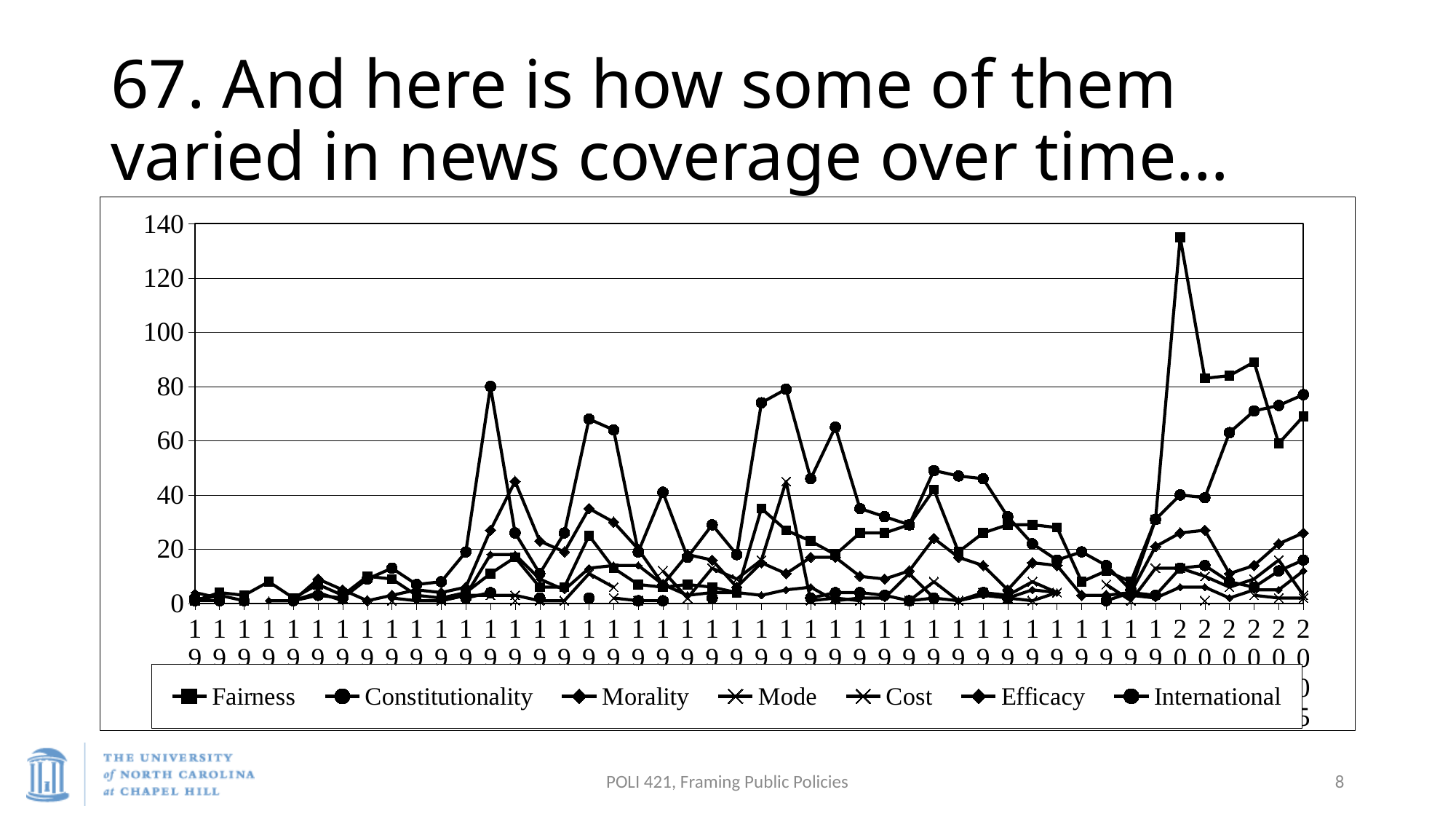
Is the highest value reached by the Fairness series greater or less than 140? less Are the Fairness values near the right end of the chart higher or lower than those near the left end? higher What kind of chart is shown on the slide? line chart Which series is listed last in the legend? International Is the highest value reached by the Fairness series greater or less than 120? greater Which series is listed first in the legend? Fairness What is the highest value shown on the vertical axis? 140 Which series reaches the highest value anywhere on the chart? Fairness How many series does the legend list? 7